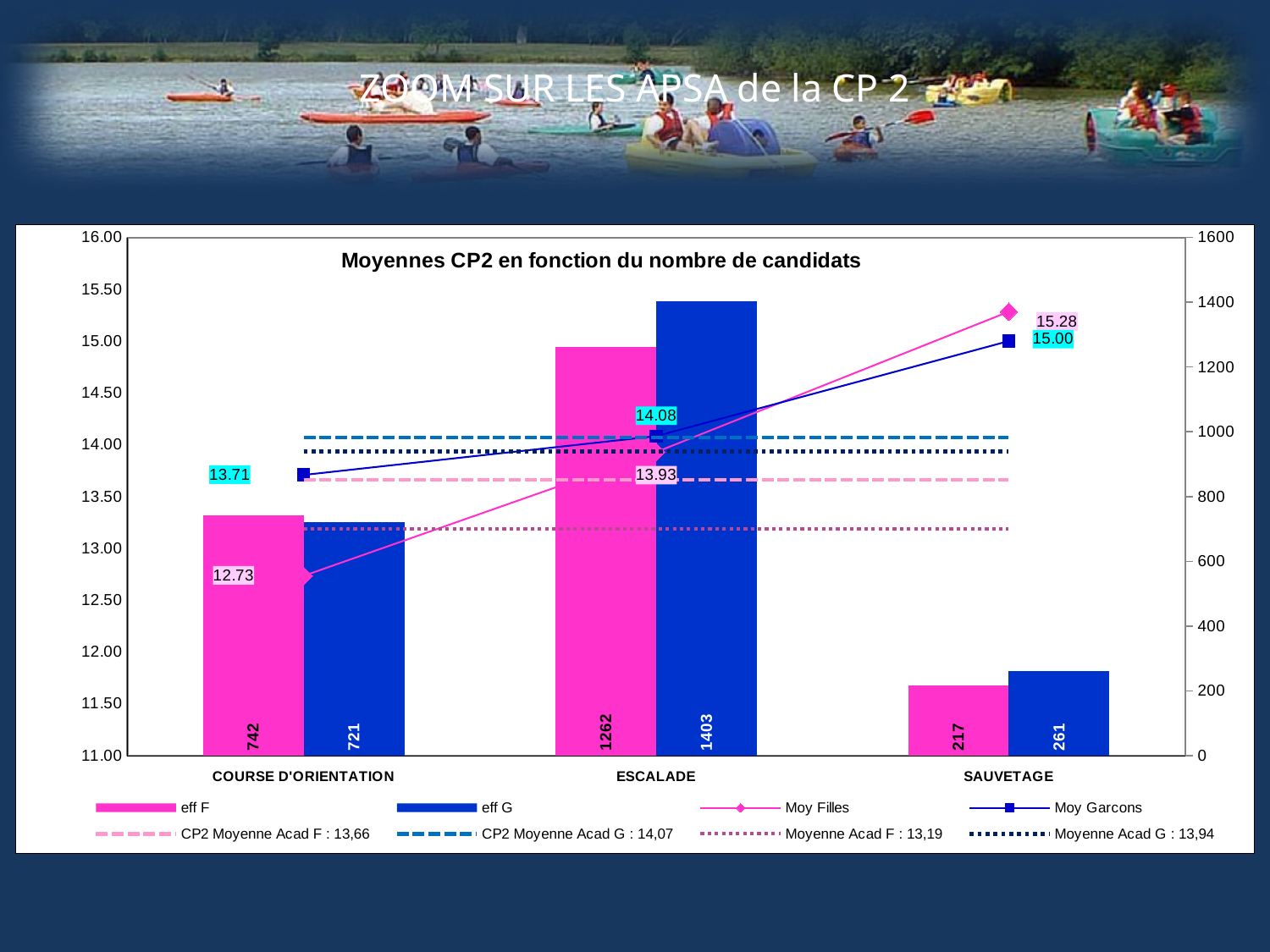
How many categories are shown on the x axis? 3 Which is larger for COURSE D'ORIENTATION, the eff F value or the eff G value? eff F Which category has the lowest eff F value? SAUVETAGE Which category has the highest eff G value? ESCALADE What is the eff G value for SAUVETAGE? 261 What is the Moy Filles value for COURSE D'ORIENTATION? 12.73 What is the difference between the eff G and eff F values for ESCALADE? 141 How many series does the legend list? 8 What is the title of the chart? Moyennes CP2 en fonction du nombre de candidats What is the Moy Garcons value for ESCALADE? 14.08 What is the eff F value for ESCALADE? 1262 Does the Moy Filles line rise or fall from COURSE D'ORIENTATION to SAUVETAGE? rise